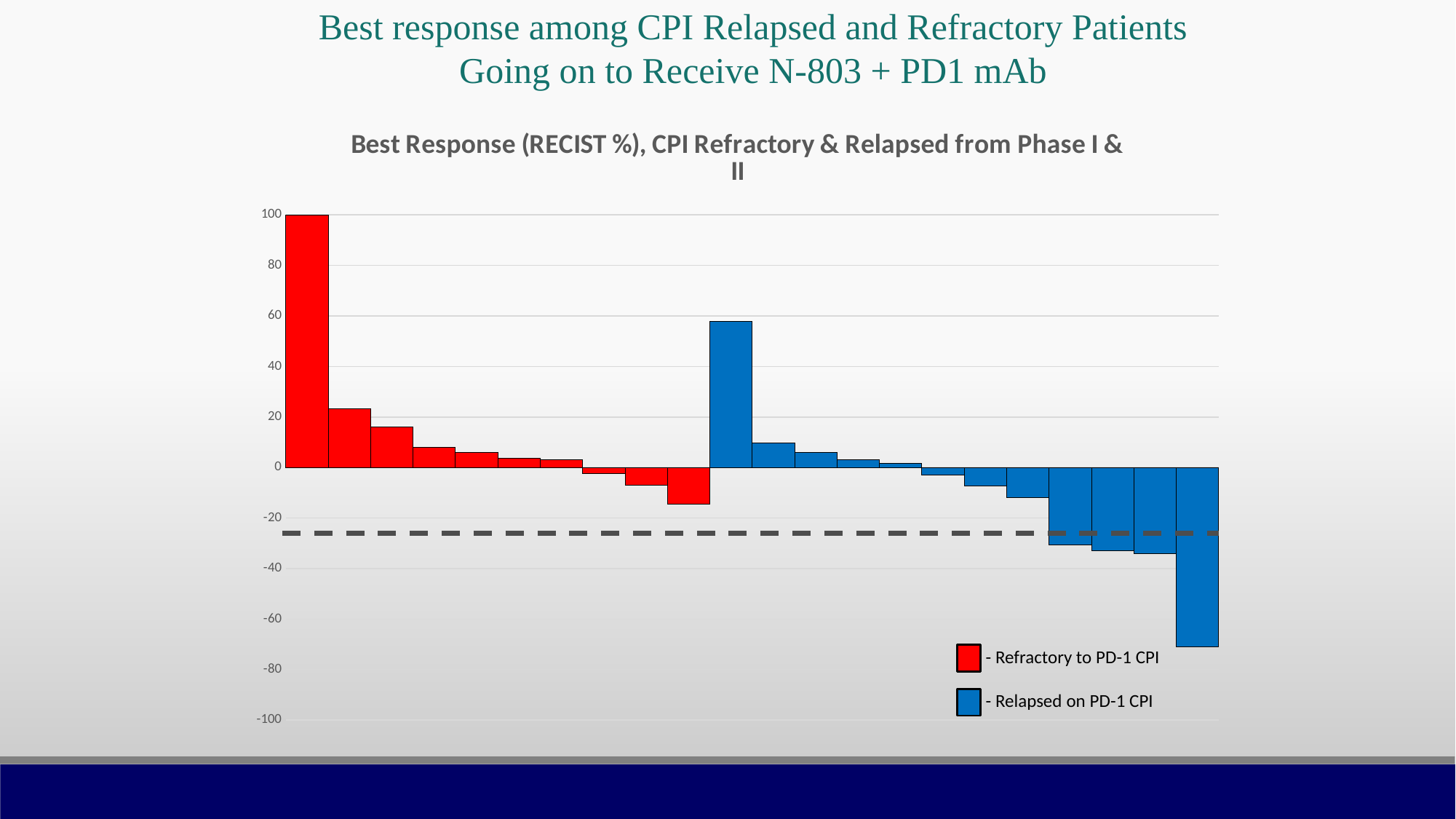
Is the value of the lowest blue bar greater or less than -60? less Is the value of the tallest red bar greater or less than 80? greater Within each colour group, do the bar values rise or fall from left to right? Fall How many blue bars are plotted in the chart? 12 How many red bars are plotted in the chart? 10 Which is larger, the tallest red bar or the tallest blue bar? The tallest red bar Is the value of the tallest blue bar greater or less than 40? greater How many series does the legend list? 2 Which series contains the bar with the lowest (most negative) value? Relapsed on PD-1 CPI What does the blue colour represent in the legend? Relapsed on PD-1 CPI What kind of chart is shown on the slide? Bar chart Which colour represents patients refractory to PD-1 CPI? Red